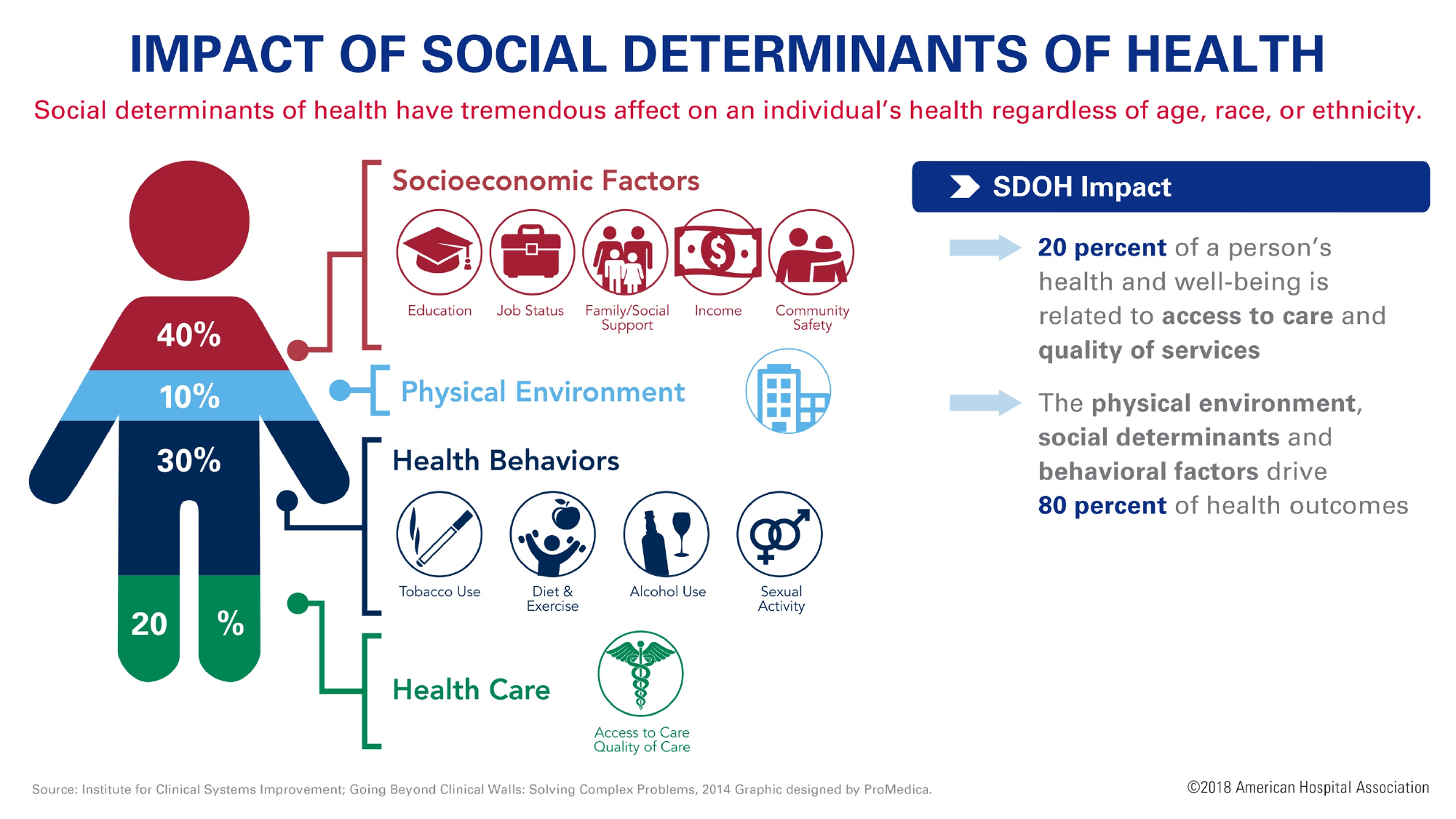
What do the four percentages on the human figure add up to? 100% What percentage of the human figure is attributed to Socioeconomic Factors? 40% What percentage of the human figure is attributed to Physical Environment? 10% What colour is the Health Care segment of the human figure? Green What is the difference in percentage points between Socioeconomic Factors and Health Care? 20 Which category accounts for the smallest share of the human figure? Physical Environment Which has a larger share, Health Behaviors or Health Care? Health Behaviors What percentage of the human figure is attributed to Health Care? 20% How many icons are shown under Socioeconomic Factors? 5 Which category accounts for the largest share of the human figure? Socioeconomic Factors What percentage of the human figure is attributed to Health Behaviors? 30% How many categories is the human figure divided into? 4